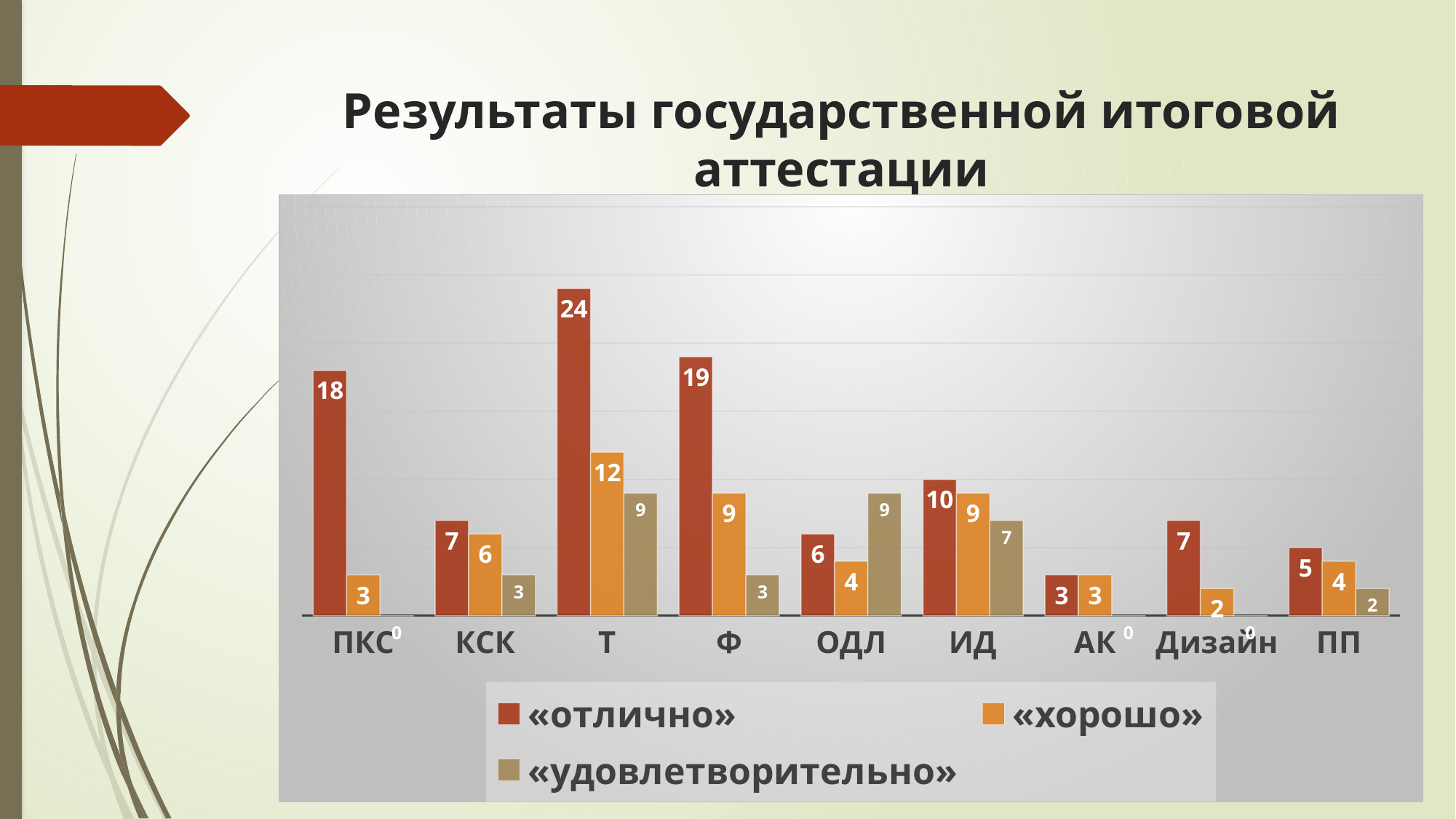
What is the «удовлетворительно» value for ОДЛ? 9 Which is larger: the «отлично» value for ПКС or the «отлично» value for ИД? ПКС What is the title of the chart on the slide? Результаты государственной итоговой аттестации How many categories are shown on the x axis? 9 What is the difference between the «отлично» values for Т and Ф? 5 What is the «отлично» value for Т? 24 How many series does the legend list? 3 What is the total of the three values for КСК? 16 What is the «хорошо» value for Ф? 9 Which category has the highest «отлично» value? Т Which category has the lowest «хорошо» value? Дизайн What type of chart is shown on the slide? bar chart